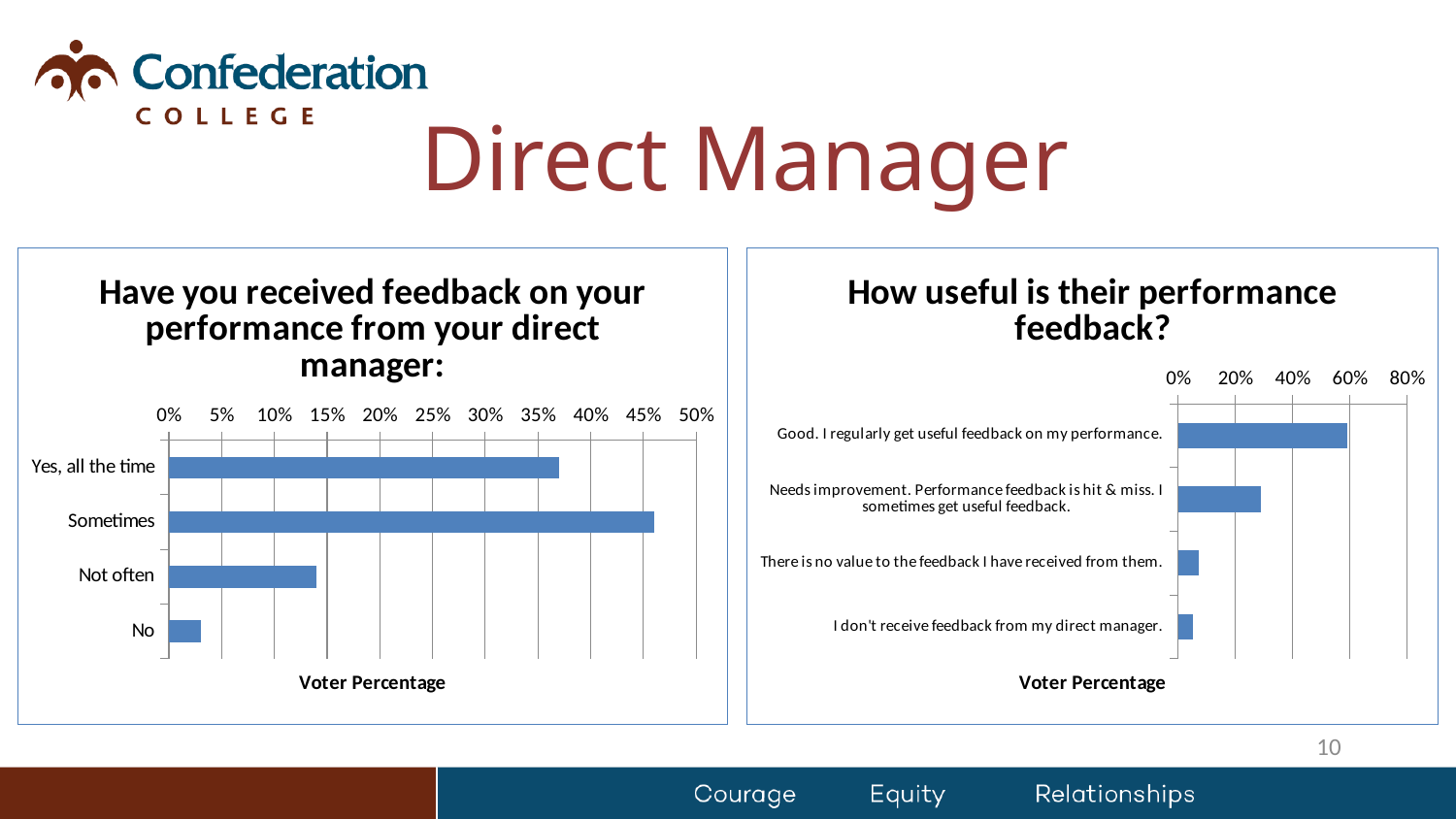
What kind of chart is the chart titled "Have you received feedback on your performance from your direct manager:"? bar chart In the chart titled "Have you received feedback on your performance from your direct manager:", which category has the highest value? Sometimes In the chart titled "How useful is their performance feedback?", how many categories are shown? 4 In the chart titled "Have you received feedback on your performance from your direct manager:", is the value for "Yes, all the time" greater or less than 30%? greater In the chart titled "Have you received feedback on your performance from your direct manager:", how many categories are shown? 4 In the chart titled "How useful is their performance feedback?", is the value for "Needs improvement. Performance feedback is hit & miss. I sometimes get useful feedback." greater or less than 40%? less In the chart titled "How useful is their performance feedback?", is the value for "Good. I regularly get useful feedback on my performance." greater or less than 40%? greater In the chart titled "Have you received feedback on your performance from your direct manager:", which is larger: the value for "Yes, all the time" or the value for "Not often"? Yes, all the time In the chart titled "How useful is their performance feedback?", what is the label on the horizontal axis? Voter Percentage In the chart titled "Have you received feedback on your performance from your direct manager:", which category has the lowest value? No In the chart titled "How useful is their performance feedback?", which category has the highest value? Good. I regularly get useful feedback on my performance.